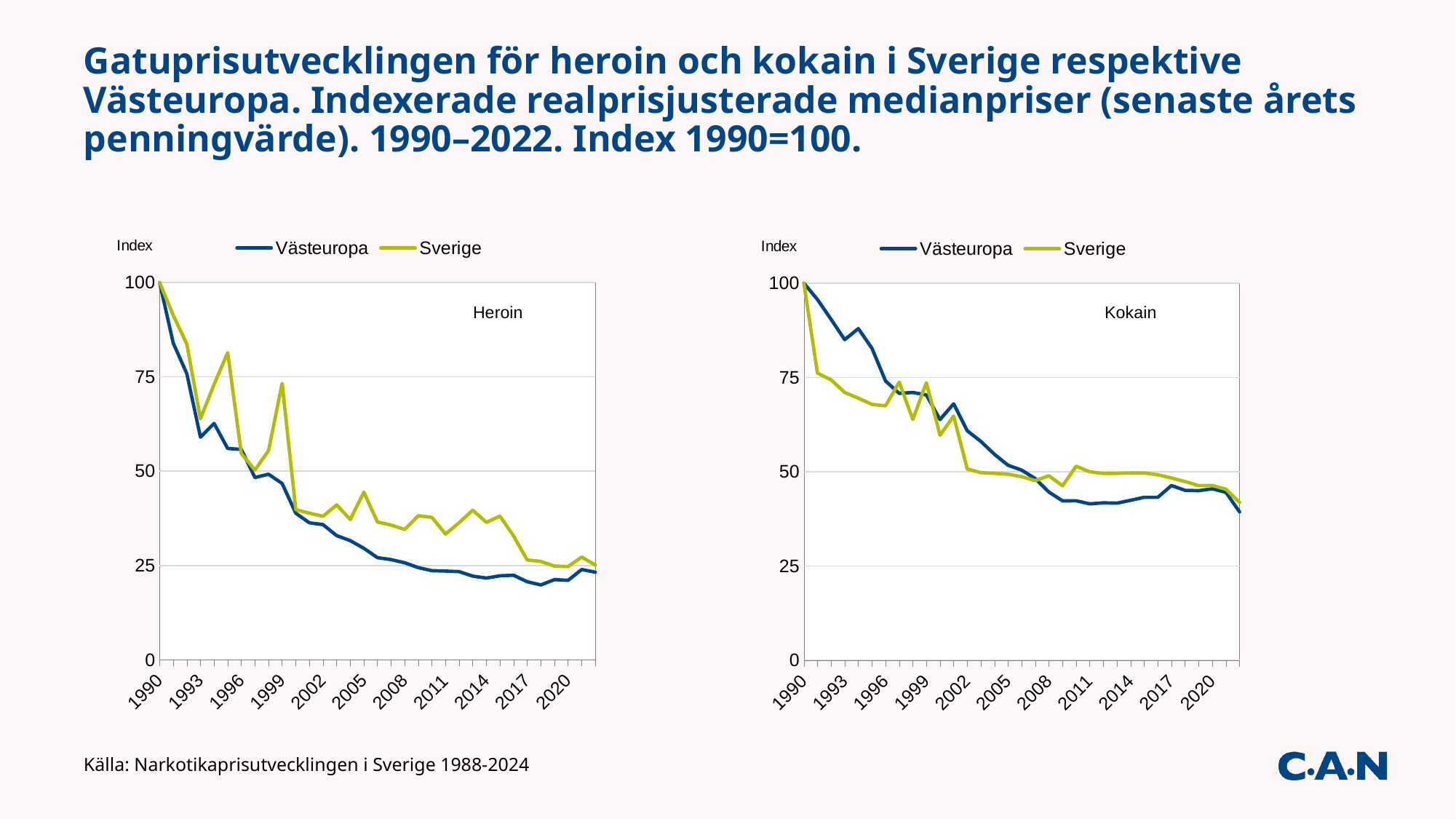
How many series does the legend of the Kokain chart list? 2 In the Heroin chart, is the value for Västeuropa in 2020 greater or less than 25? less In the Kokain chart, which series has the higher value in 1993, Västeuropa or Sverige? Västeuropa Which series is drawn in yellow-green in both charts? Sverige In the Heroin chart, is the value for Sverige in 1999 greater or less than 50? greater In the Kokain chart, is the value for Sverige in 2011 greater or less than 75? less In the Heroin chart, what is the index value for Sverige in 1990? 100 In the Kokain chart, do the index values for Västeuropa generally rise or fall from 1990 to 2022? fall In the Kokain chart, what is the index value for Västeuropa in 1990? 100 What type of chart is the Heroin chart on the left? line chart